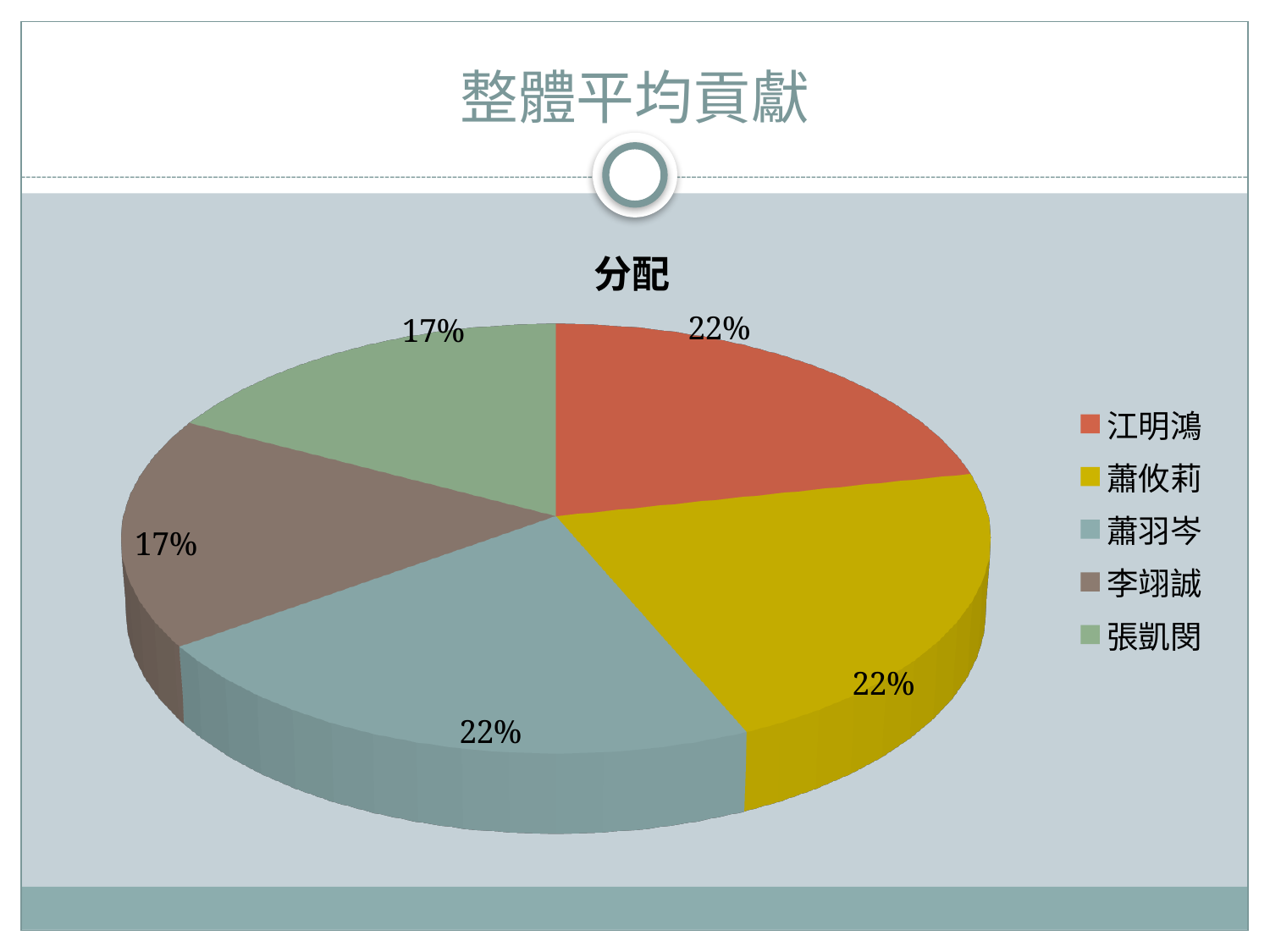
What is the title of the chart? 分配 Which is larger, the share for 江明鴻 or the share for 李翊誠? 江明鴻 Which colour represents 蕭羽岑 in the legend? teal (blue-grey) What kind of chart is shown on the slide? pie chart What share of the pie does 蕭羽岑 have? 22% What is the difference between the share for 蕭攸莉 and the share for 張凱閔? 5% What share of the pie does 李翊誠 have? 17% What share of the pie does 江明鴻 have? 22% How many entries does the legend list? 5 How many slices does the pie chart have? 5